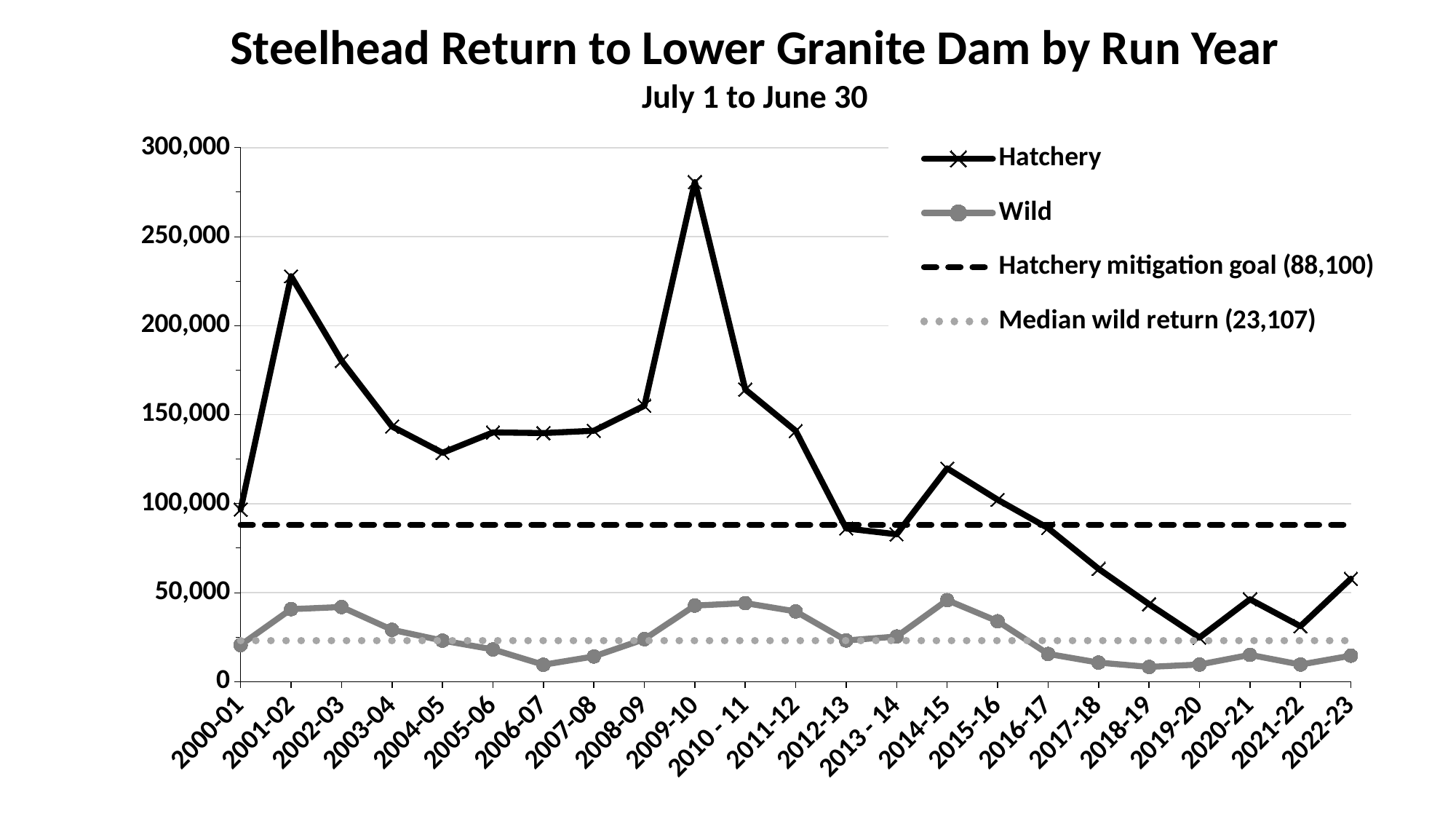
How many entries does the legend list? 4 Which is larger, the Hatchery return in 2014-15 or in 2015-16? 2014-15 Is the Hatchery value for 2012-13 greater or less than 100,000? less In which run year is the Hatchery return lowest? 2019-20 How many run years are plotted along the x axis? 23 In which run year is the Hatchery return highest? 2009-10 What kind of chart is shown on the slide? line chart Is the Hatchery value for 2001-02 greater or less than 200,000? greater What is the hatchery mitigation goal shown in the legend? 88,100 What is the median wild return shown in the legend? 23,107 Does the Hatchery return rise or fall from 2016-17 to 2019-20? fall What is the title of the chart? Steelhead Return to Lower Granite Dam by Run Year